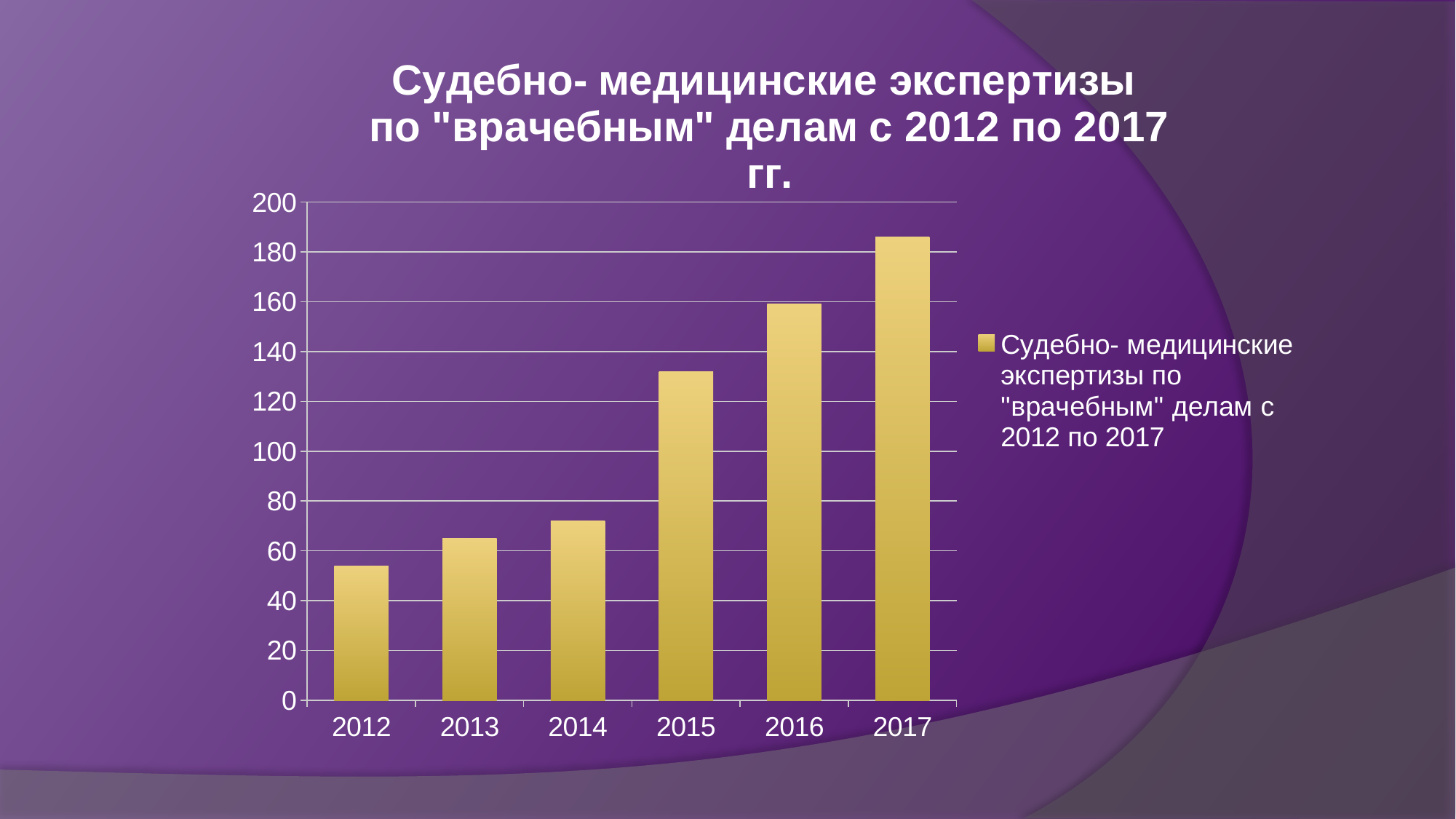
Is the value for 2013 greater or less than 60? greater Do the values rise or fall from 2012 to 2017? rise Which year has the lowest value? 2012 What kind of chart is shown on the slide? bar chart Is the value for 2014 greater or less than 80? less Which year has the highest value? 2017 How many series does the legend list? 1 Is the value for 2015 greater or less than 120? greater Which is larger, the value for 2015 or the value for 2016? 2016 How many years are shown on the x axis of the chart? 6